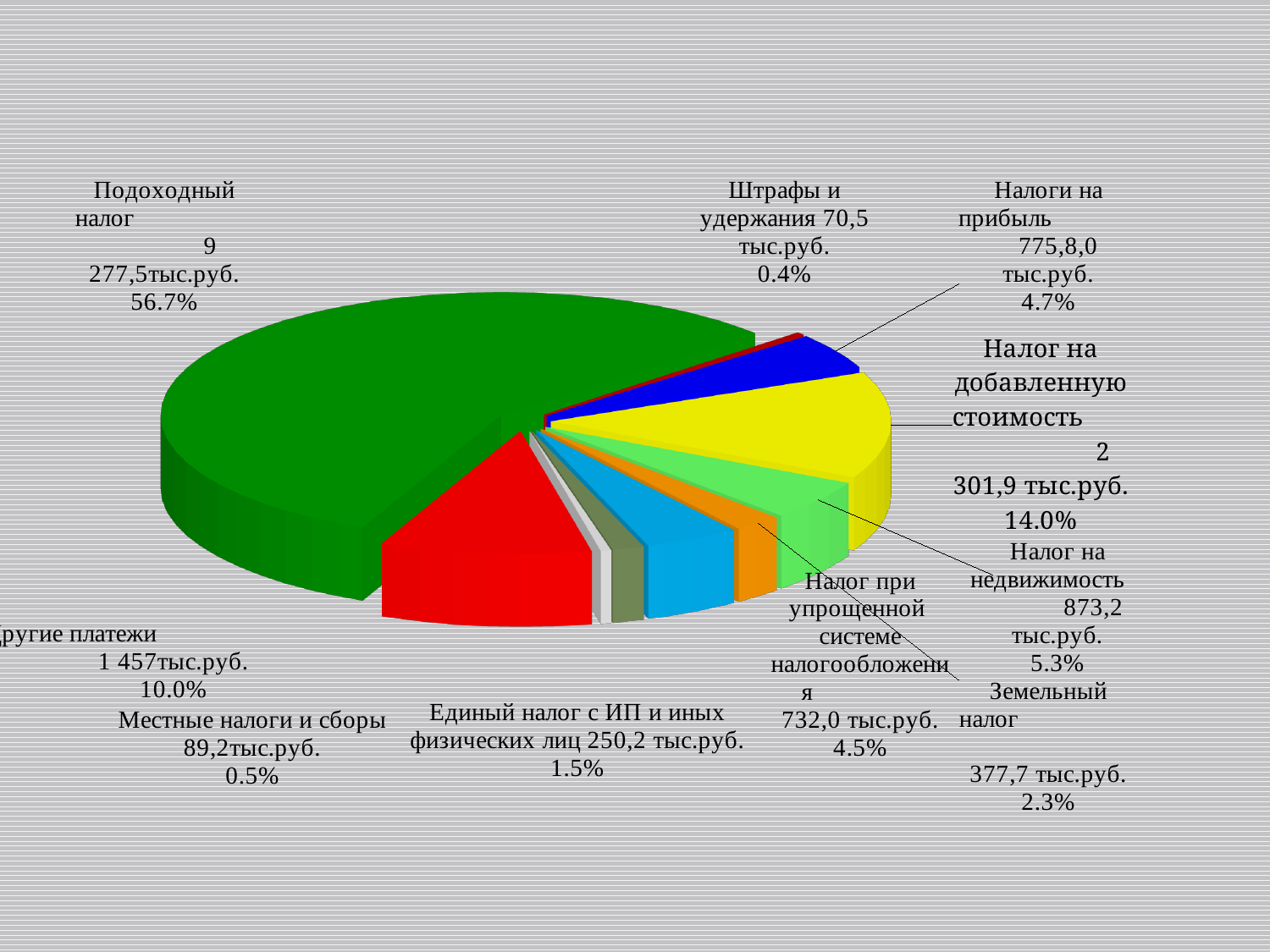
How many categories (slices) does the pie chart have? 10 What is the value shown for Другие платежи? 1 457тыс.руб. What is the difference in percentage points between the shares of Налог на добавленную стоимость and Другие платежи? 4.0 What share of the pie does Подоходный налог represent? 56.7% Which category has the largest share of the pie? Подоходный налог What is the value shown for Налог на недвижимость? 873,2 тыс.руб. Which category has the smallest share of the pie? Штрафы и удержания What share of the pie does Единый налог с ИП и иных физических лиц represent? 1.5% Which has a larger share: Налог на недвижимость or Налог при упрощенной системе налогообложения? Налог на недвижимость What kind of chart is shown on the slide? Pie chart What is the value shown for Земельный налог? 377,7 тыс.руб. What share of the pie does Налог на добавленную стоимость represent? 14.0%